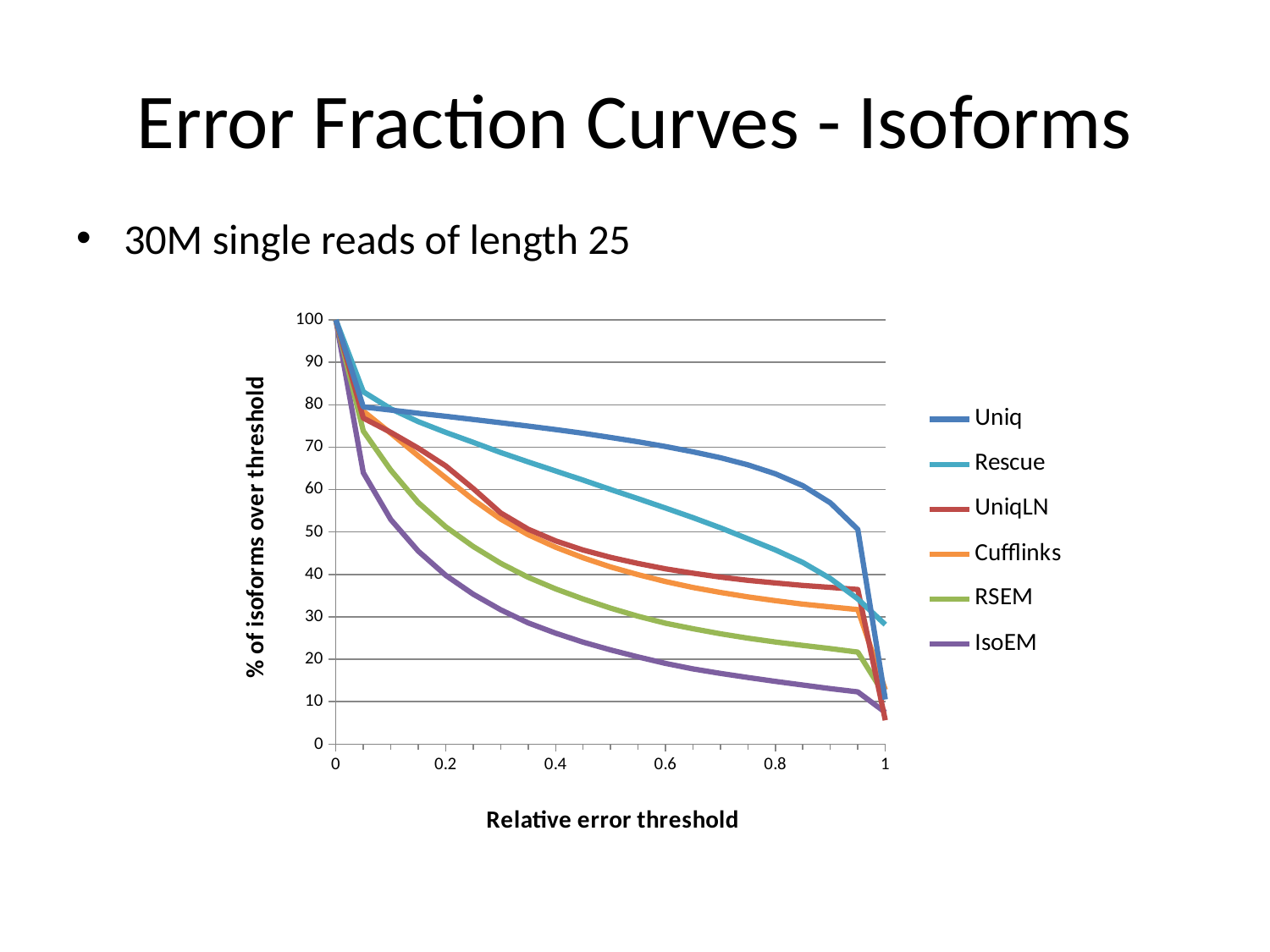
Which series has the highest value at a relative error threshold of 0.6? Uniq What is the title of the x axis? Relative error threshold Is the value for Uniq at a relative error threshold of 0.6 greater or less than 60? greater What kind of chart is shown on the slide? line chart Do the values of the curves rise or fall as the relative error threshold increases? fall How many series does the legend list? 6 Is the value for RSEM at a relative error threshold of 0.8 greater or less than 30? less Is the value for IsoEM at a relative error threshold of 0.2 greater or less than 50? less Which series has the lowest value at a relative error threshold of 0.4? IsoEM What is the value of the Uniq series at a relative error threshold of 0? 100 At a relative error threshold of 0.4, which series has the larger value, Rescue or Cufflinks? Rescue At a relative error threshold of 0.8, which series has the larger value, Uniq or IsoEM? Uniq